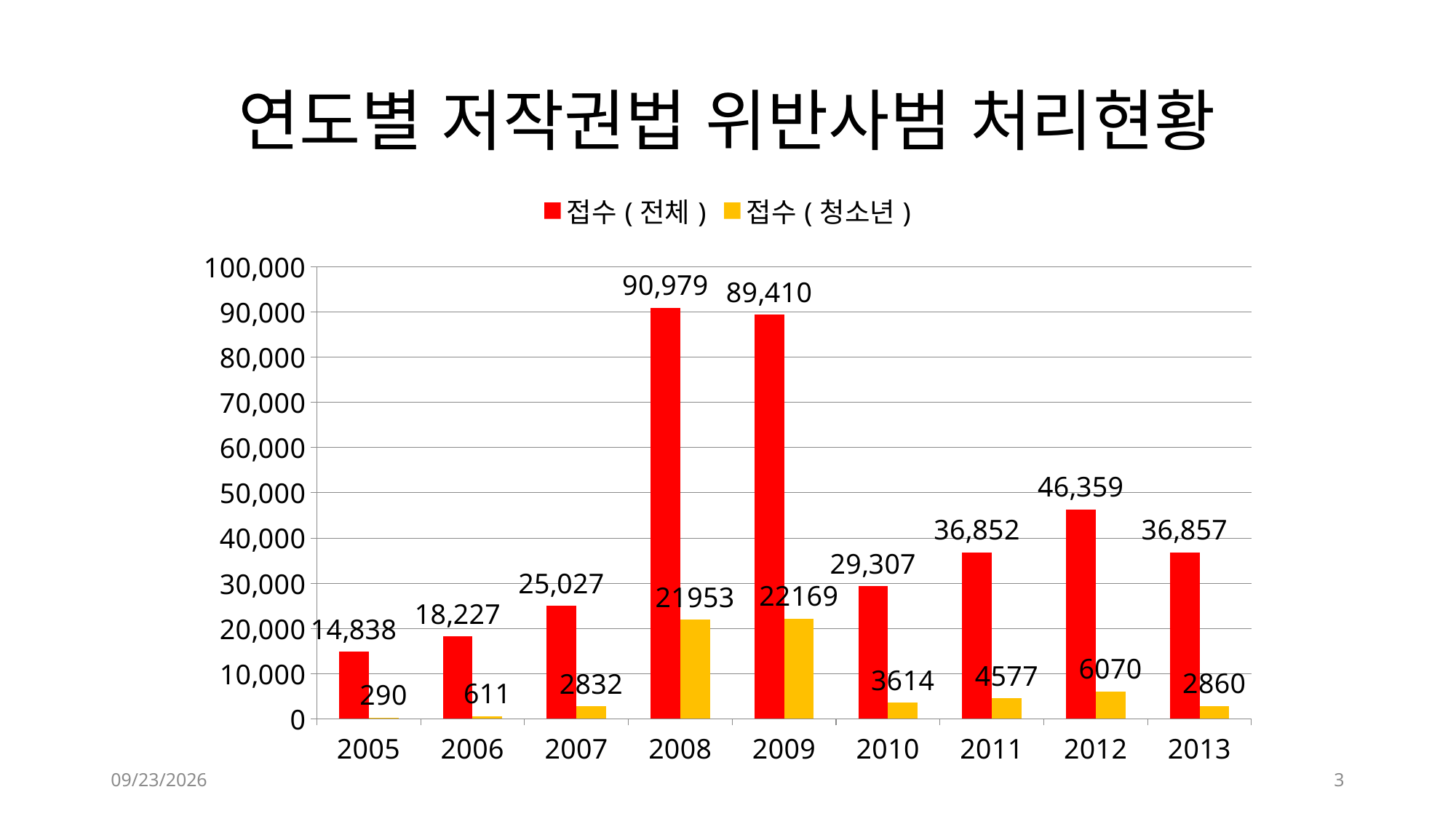
Is the value of 접수 ( 전체 ) for 2012 greater or less than 40,000? greater Which is larger, the 접수 ( 청소년 ) value for 2008 or for 2009? 2009 What is the value of 접수 ( 전체 ) for 2008? 90,979 How many series does the legend list? 2 What is the difference between the 접수 ( 전체 ) values for 2008 and 2009? 1,569 What is the value of 접수 ( 청소년 ) for 2012? 6070 What is the value of 접수 ( 전체 ) for 2005? 14,838 Which year has the highest value for 접수 ( 전체 )? 2008 Which year has the lowest value for 접수 ( 청소년 )? 2005 What colour are the bars for 접수 ( 청소년 )? yellow How many years are shown on the x axis? 9 What kind of chart is shown on the slide? bar chart